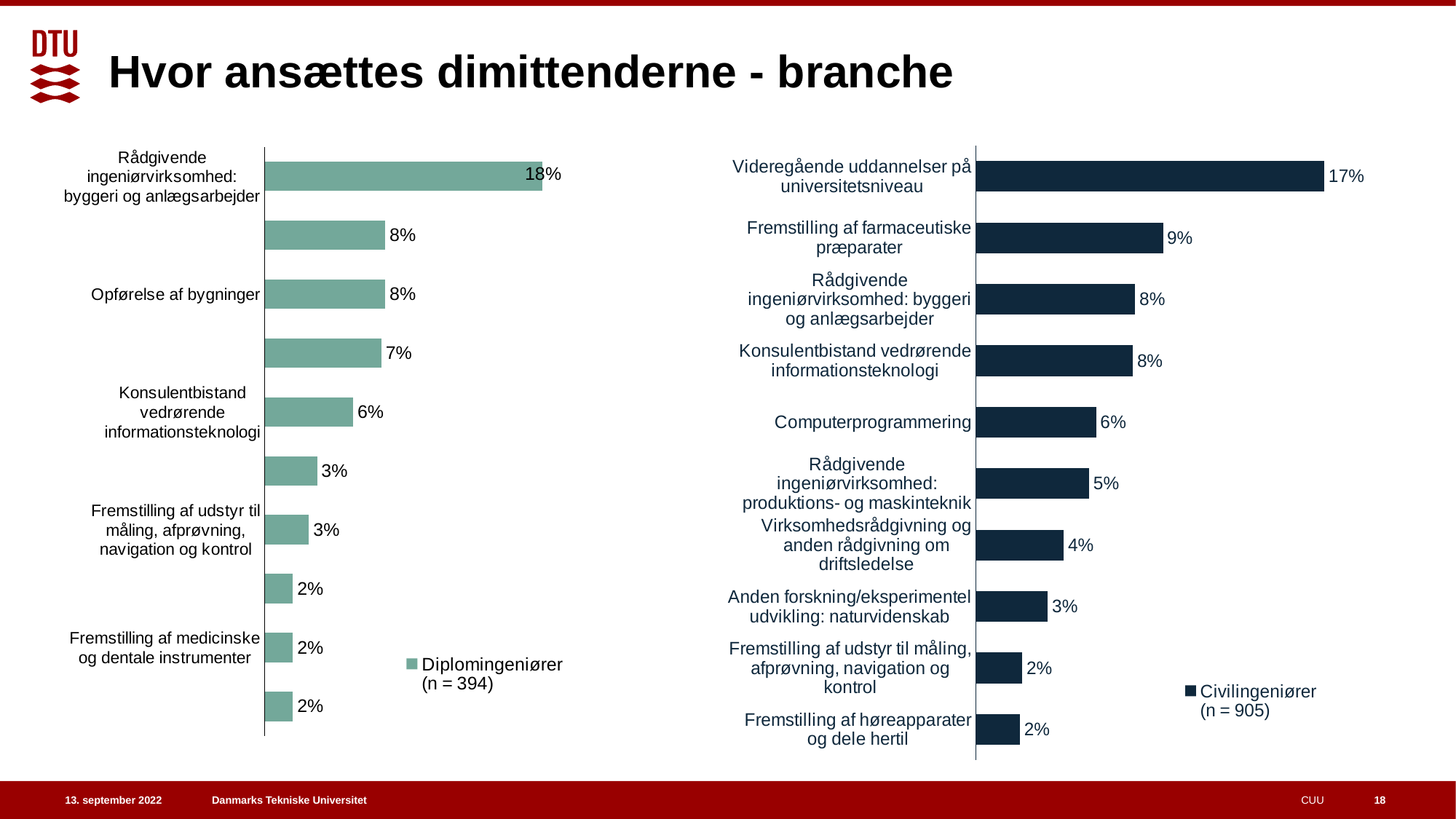
What type of chart is the left chart (Diplomingeniører)? Bar chart What sample size (n) is given in the legend of the right chart (Civilingeniører)? n = 905 In the left chart (Diplomingeniører), what is the value for Konsulentbistand vedrørende informationsteknologi? 6% In the left chart (Diplomingeniører), what is the value for Rådgivende ingeniørvirksomhed: byggeri og anlægsarbejder? 18% In the right chart (Civilingeniører), what is the value for Videregående uddannelser på universitetsniveau? 17% In the right chart (Civilingeniører), which category has the highest value? Videregående uddannelser på universitetsniveau In the left chart (Diplomingeniører), which category has the highest value? Rådgivende ingeniørvirksomhed: byggeri og anlægsarbejder In the left chart (Diplomingeniører), what is the value for Opførelse af bygninger? 8% In the right chart (Civilingeniører), what is the value for Computerprogrammering? 6% In the right chart (Civilingeniører), which is larger: Fremstilling af farmaceutiske præparater or Virksomhedsrådgivning og anden rådgivning om driftsledelse? Fremstilling af farmaceutiske præparater How many bars are shown in the right chart (Civilingeniører)? 10 In the right chart (Civilingeniører), what is the difference between Videregående uddannelser på universitetsniveau and Fremstilling af farmaceutiske præparater? 8%